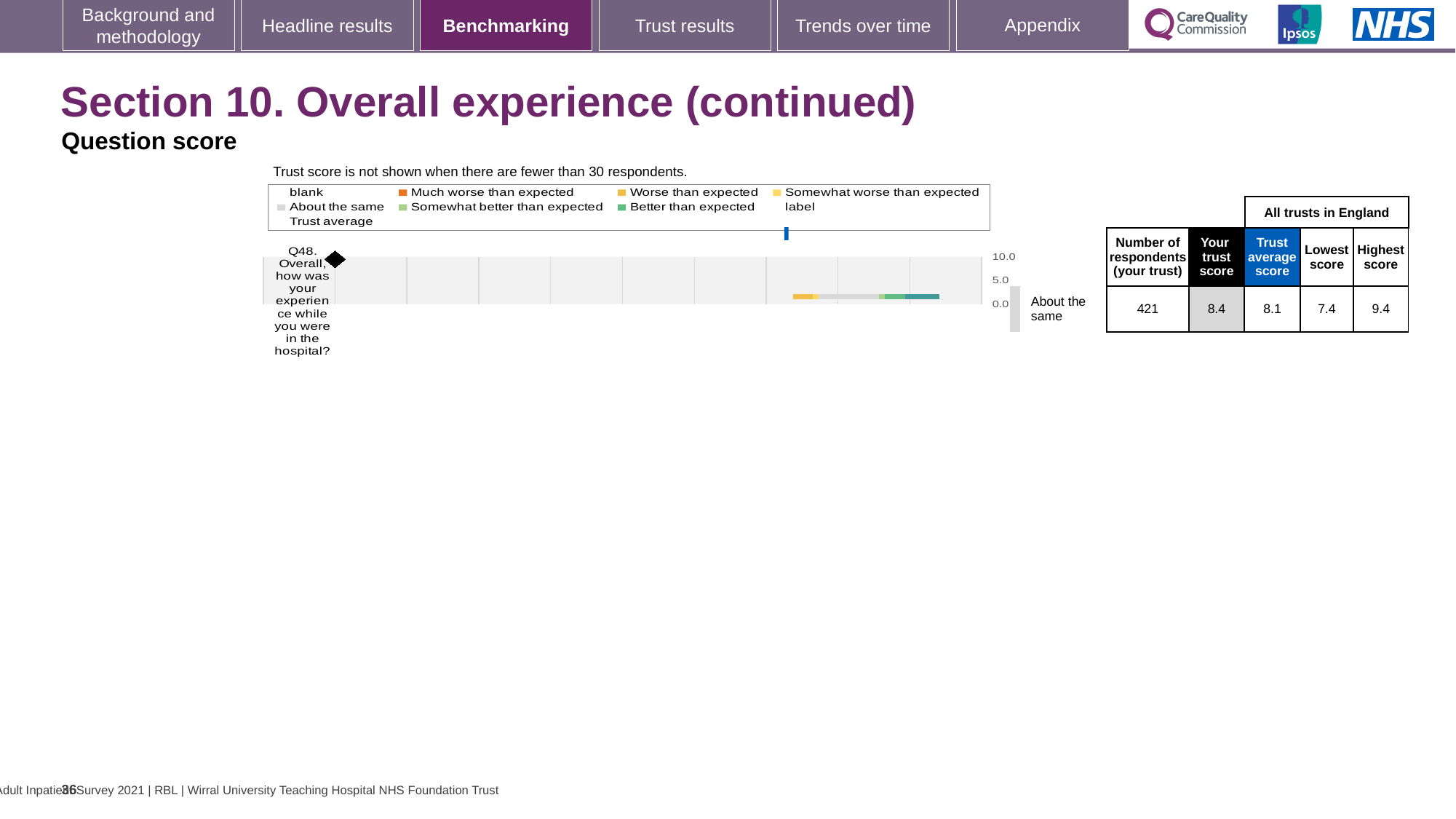
How many questions are plotted on the chart? 1 What is the trust average score for Q48 across all trusts in England? 8.1 Which colour in the legend represents 'Much worse than expected'? Orange What is the difference between the highest score and the lowest score for Q48? 2.0 By how much does the trust's score for Q48 exceed the trust average score? 0.3 Which is larger for Q48: the trust's own score or the trust average score? Your trust score (8.4) What kind of chart is used to show the Q48 question score? bar chart What benchmark category is the trust's Q48 score placed in? About the same What is the lowest score among all trusts in England for Q48? 7.4 What is the trust's score for Q48 (Overall, how was your experience while you were in the hospital?)? 8.4 What is the highest score among all trusts in England for Q48? 9.4 How many respondents from the trust answered Q48? 421